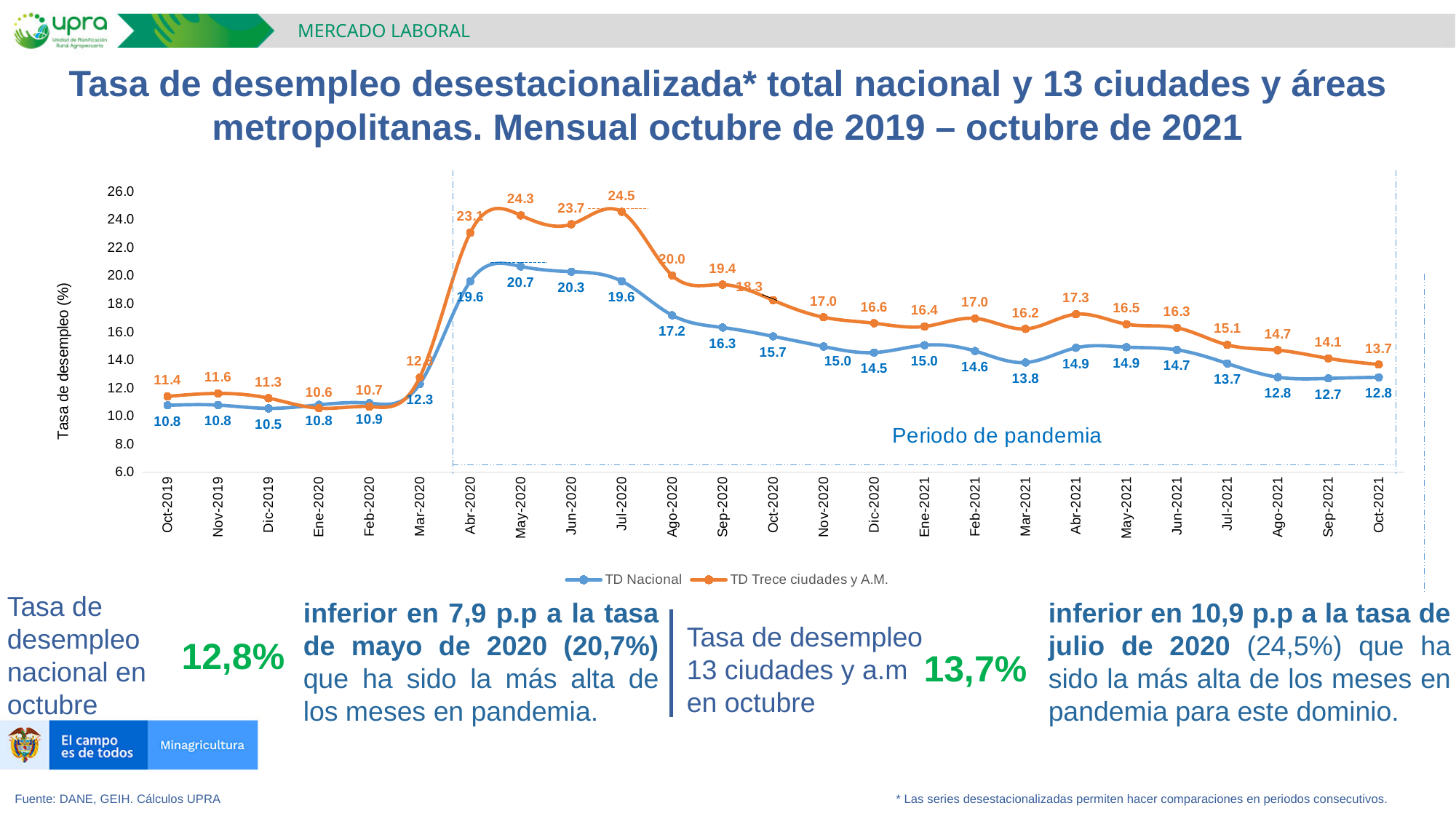
What is the value of TD Nacional in Oct-2021? 12.8 In Ene-2020, which series has the larger value, TD Nacional or TD Trece ciudades y A.M.? TD Nacional In which month does TD Nacional reach its lowest value? Dic-2019 What are the two series named in the legend? TD Nacional and TD Trece ciudades y A.M. What is the value of TD Trece ciudades y A.M. in Jul-2020? 24.5 In which month does TD Nacional reach its highest value? May-2020 What kind of chart is shown on the slide? Line chart How many months are plotted on the x axis? 25 From Jul-2020 to Oct-2021, does TD Trece ciudades y A.M. generally rise or fall? Fall In which month does TD Trece ciudades y A.M. reach its highest value? Jul-2020 How many series does the legend list? 2 What is the difference between TD Trece ciudades y A.M. and TD Nacional in Oct-2021? 0.9